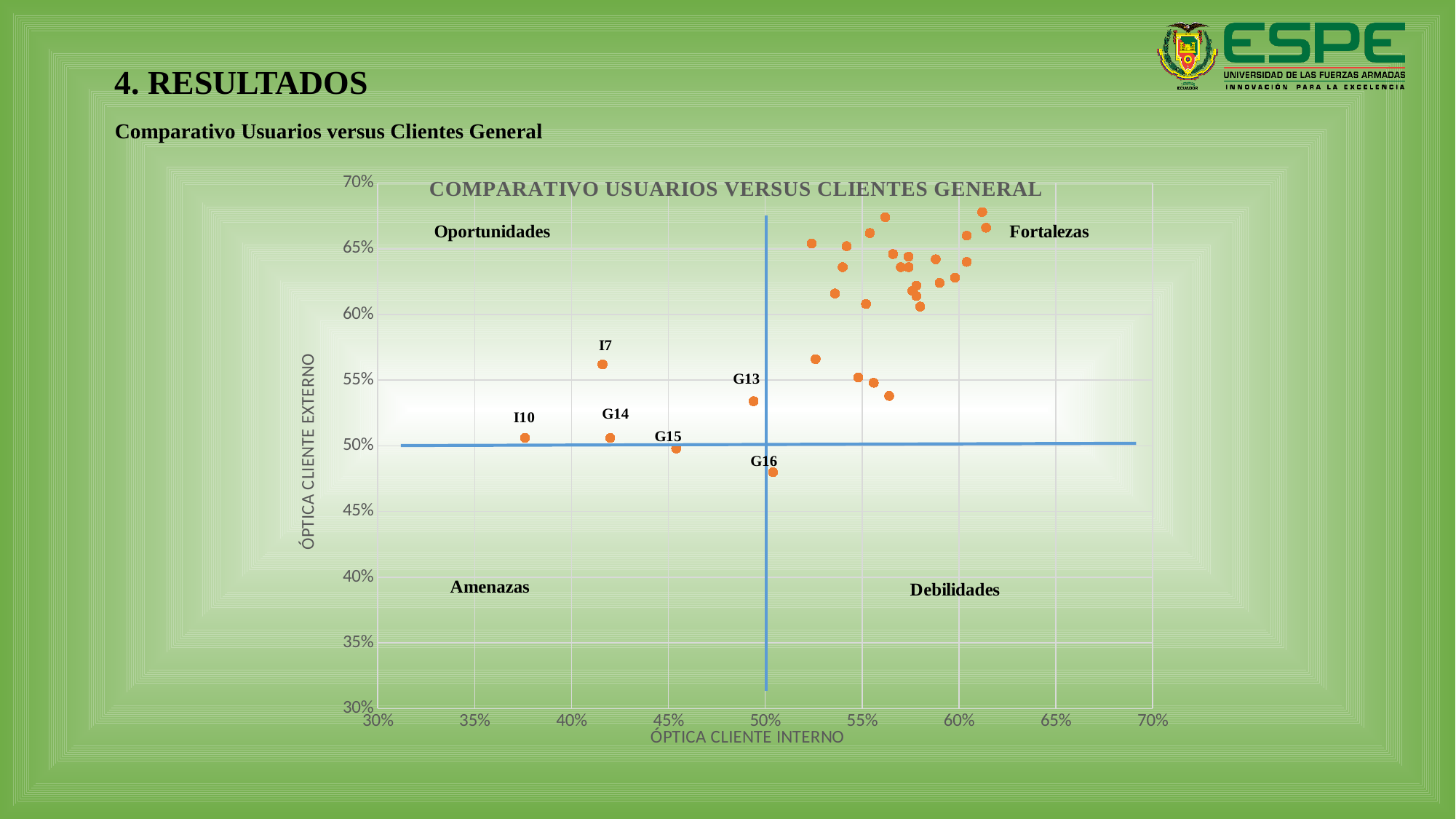
Among the labelled points (I7, I10, G13, G14, G15, G16), which has the highest vertical-axis value? I7 Which of the labelled points, I10 or G13, has the larger horizontal-axis value? G13 Among the labelled points (I7, I10, G13, G14, G15, G16), which has the lowest vertical-axis value? G16 What is the title of the chart? COMPARATIVO USUARIOS VERSUS CLIENTES GENERAL Is the horizontal-axis value for point I7 greater or less than 45%? less What is the label of the vertical axis? ÓPTICA CLIENTE EXTERNO Is the vertical-axis value for point G13 greater or less than 55%? less Is the vertical-axis value for point G16 greater or less than 50%? less What kind of chart is shown on the slide? scatter chart Which of the labelled points, I7 or G16, has the higher vertical-axis value? I7